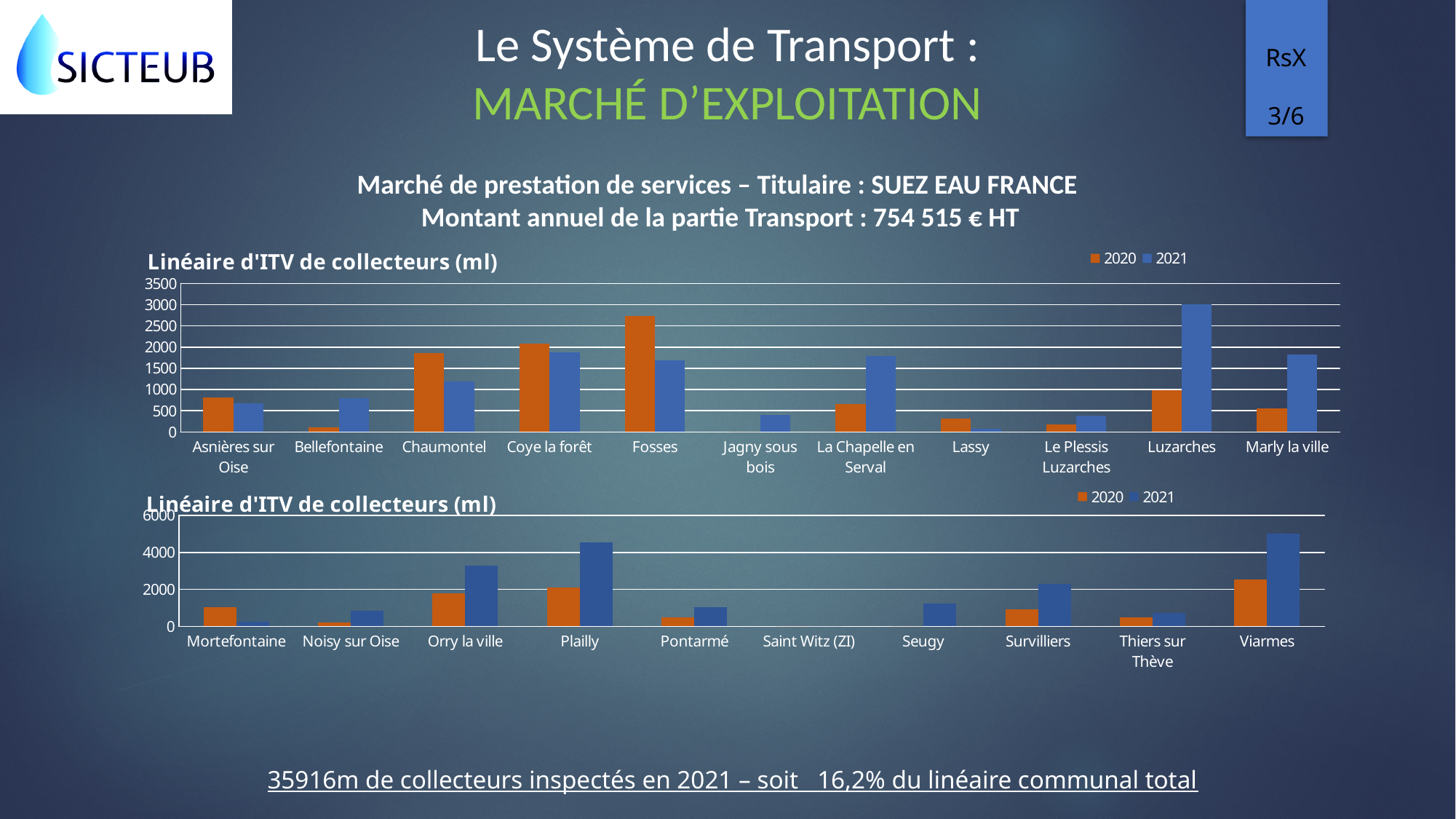
In the bottom chart, how many communes are shown on the x axis? 10 In the top chart, how many communes are shown on the x axis? 11 In the top chart, which is larger for Chaumontel, the 2020 value or the 2021 value? 2020 In the bottom chart, is the 2021 value for Plailly greater or less than 4000? greater What kind of chart is the top chart on the slide? bar chart In the top chart, is the 2021 value for Luzarches greater or less than 2500? greater In the top chart, which commune has the highest 2020 value? Fosses In the bottom chart, which commune has the highest 2021 value? Viarmes In the top chart, how many series does the legend list? 2 In the top chart, which commune has the highest 2021 value? Luzarches In the bottom chart, which is larger for Orry la ville, the 2020 value or the 2021 value? 2021 In the top chart, which colour represents the 2021 series? blue